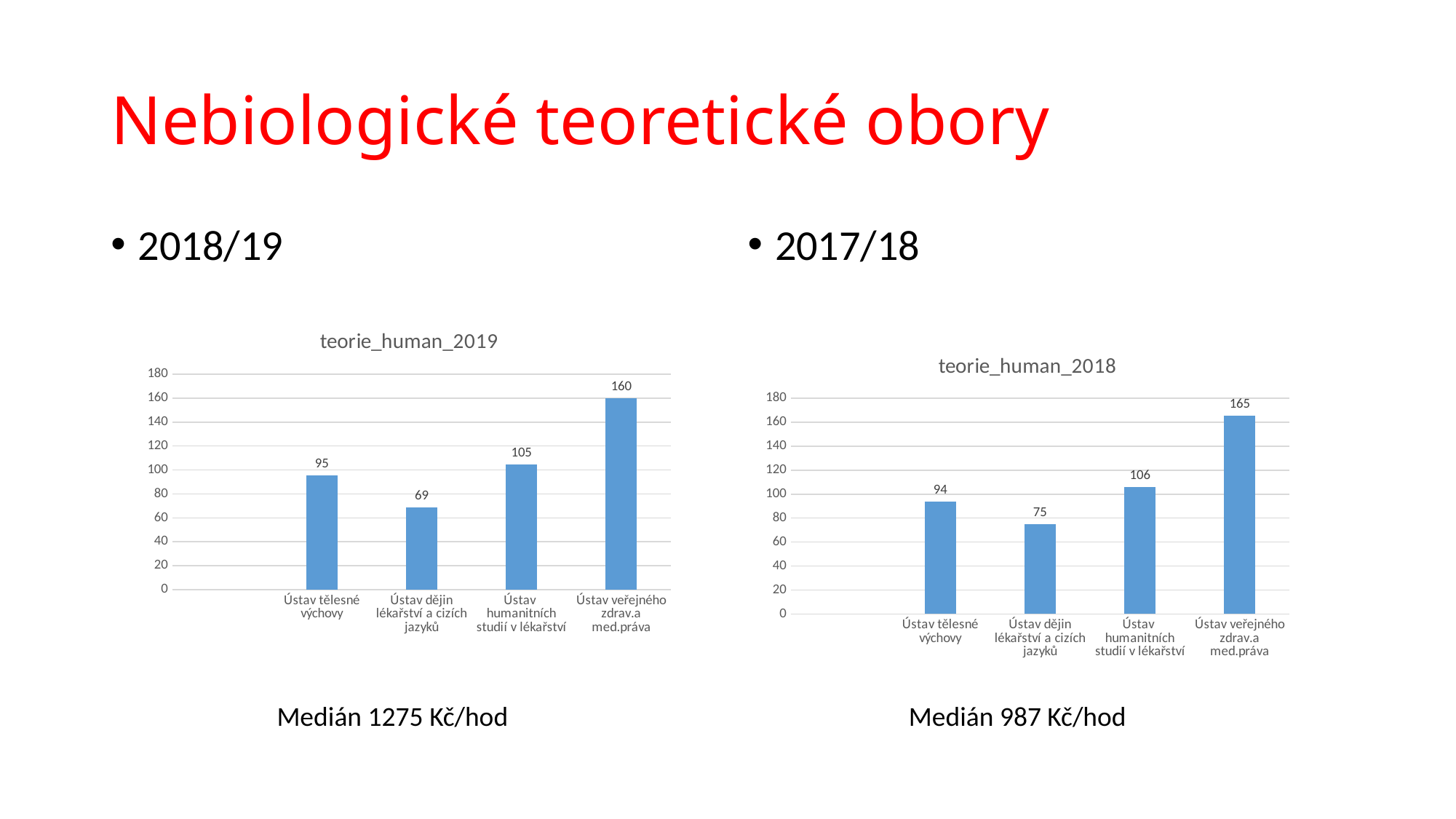
What is the title of the chart on the left side of the slide? teorie_human_2019 In the teorie_human_2019 chart, what is the value for Ústav tělesné výchovy? 95 In the teorie_human_2018 chart, which category has the lowest value? Ústav dějin lékařství a cizích jazyků In the teorie_human_2018 chart, is the value for Ústav veřejného zdrav.a med.práva greater or less than 140? greater In the teorie_human_2019 chart, which category has the highest value? Ústav veřejného zdrav.a med.práva In the teorie_human_2018 chart, what is the value for Ústav veřejného zdrav.a med.práva? 165 In the teorie_human_2019 chart, which is larger: the value for Ústav humanitních studií v lékařství or the value for Ústav tělesné výchovy? Ústav humanitních studií v lékařství What kind of chart is teorie_human_2018? bar chart In the teorie_human_2019 chart, what is the difference between the values for Ústav veřejného zdrav.a med.práva and Ústav dějin lékařství a cizích jazyků? 91 In the teorie_human_2018 chart, what is the difference between the values for Ústav humanitních studií v lékařství and Ústav tělesné výchovy? 12 How many categories are shown in the teorie_human_2019 chart? 4 In the teorie_human_2018 chart, what is the value for Ústav dějin lékařství a cizích jazyků? 75